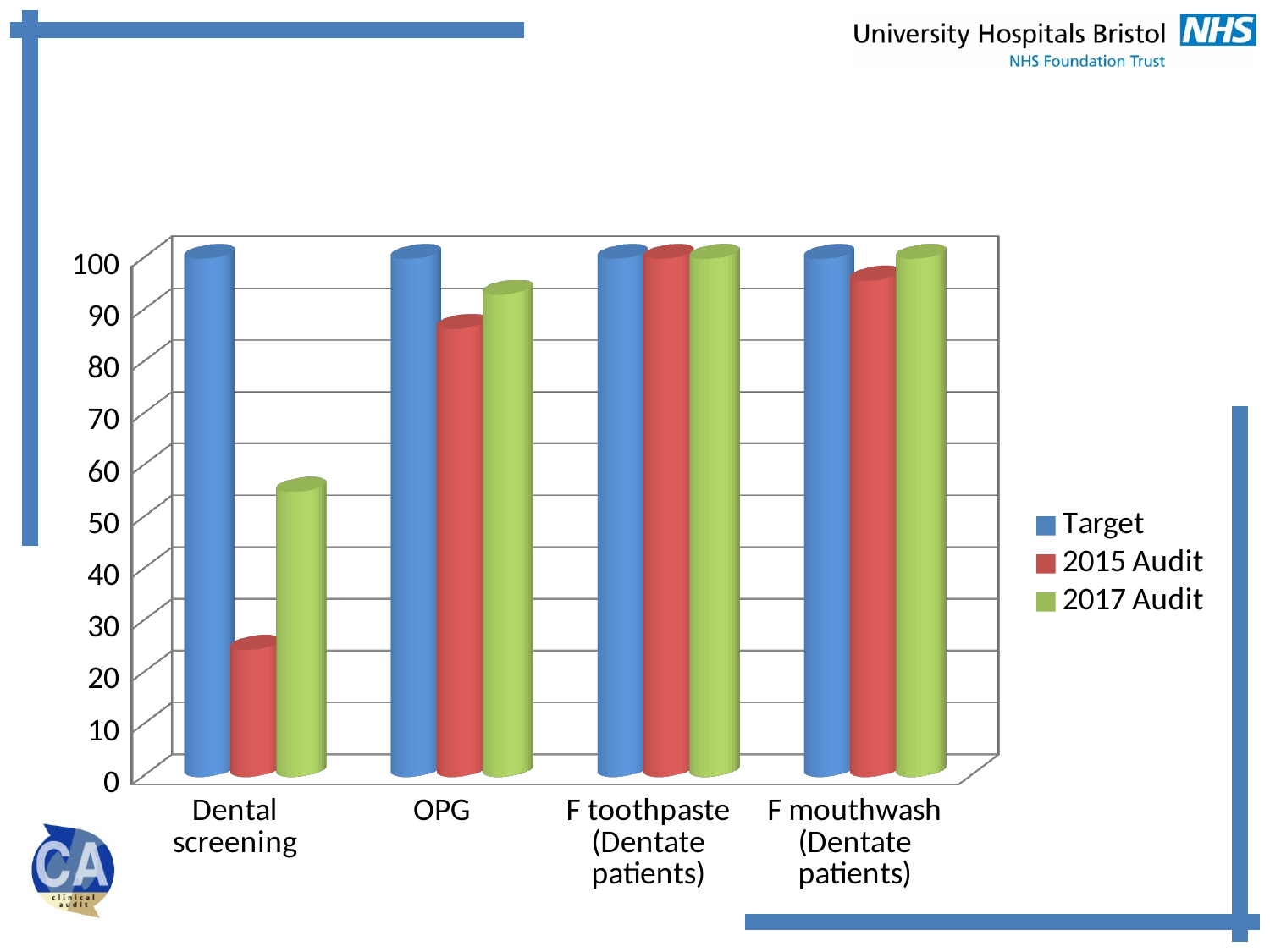
Is the 2015 Audit value for OPG greater or less than 80? greater Which category has the lowest 2017 Audit value? Dental screening Is the 2015 Audit value for Dental screening greater or less than 30? less How many categories are shown along the x axis? 4 For OPG, which is larger: the 2015 Audit value or the 2017 Audit value? 2017 Audit How many series does the legend list? 3 For Dental screening, which is larger: the 2015 Audit value or the 2017 Audit value? 2017 Audit What kind of chart is shown on the slide? bar chart Is the 2015 Audit value for F mouthwash (Dentate patients) greater or less than 90? greater Which colour represents the Target series in the legend? blue Which category has the lowest 2015 Audit value? Dental screening